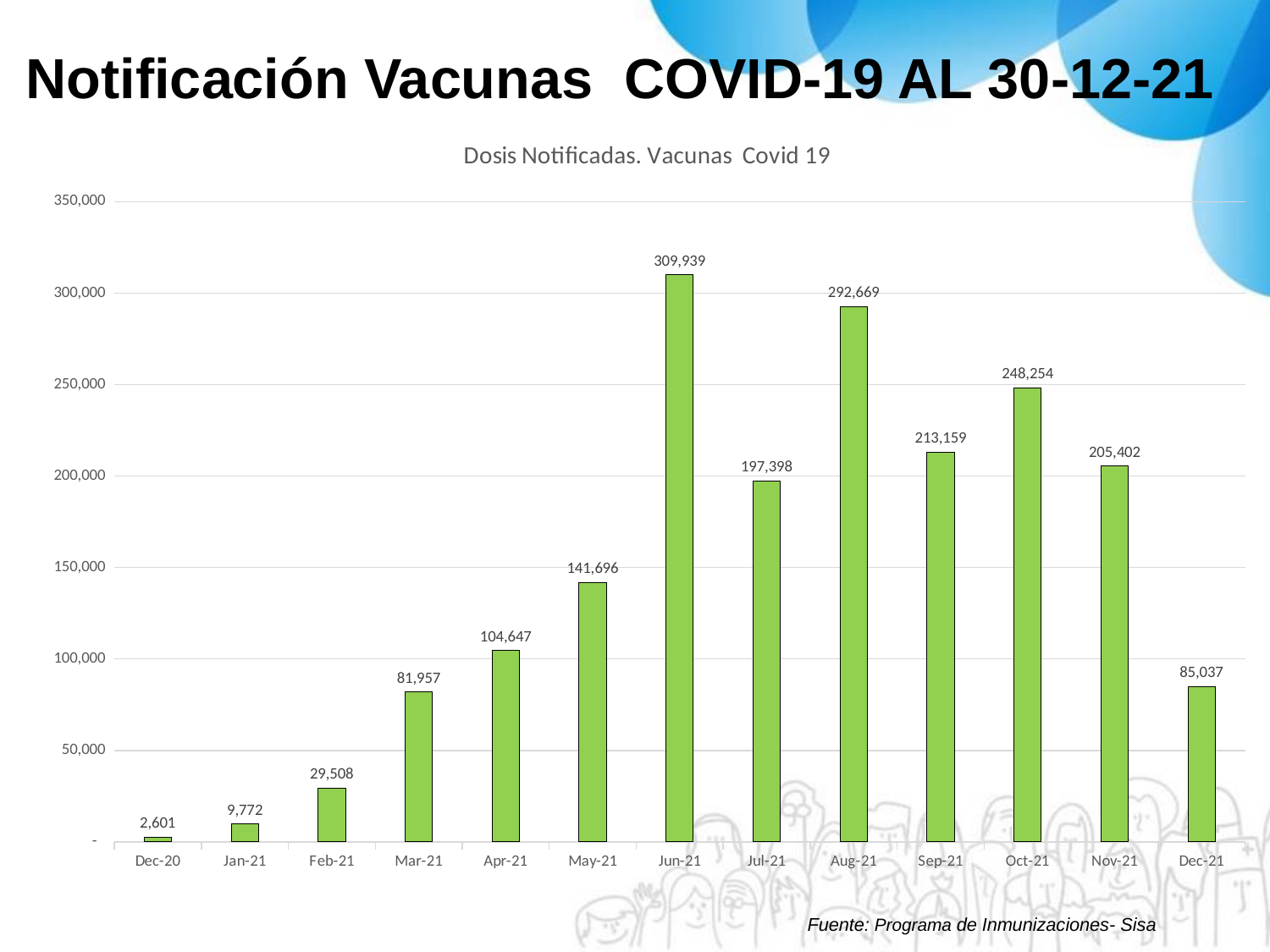
Which is larger, the value for Sep-21 or the value for Jul-21? Sep-21 Which month has the lowest value? Dec-20 What is the value for Dec-21? 85,037 What kind of chart is shown? bar chart How many months are shown on the x axis? 13 Which month has the highest value? Jun-21 What is the value for Mar-21? 81,957 Do the values rise or fall from Dec-20 to Jun-21? rise What is the value for Jun-21? 309,939 What is the difference between the values for Jun-21 and Aug-21? 17,270 What is the difference between the values for Oct-21 and Nov-21? 42,852 Is the value for May-21 greater or less than 150,000? less